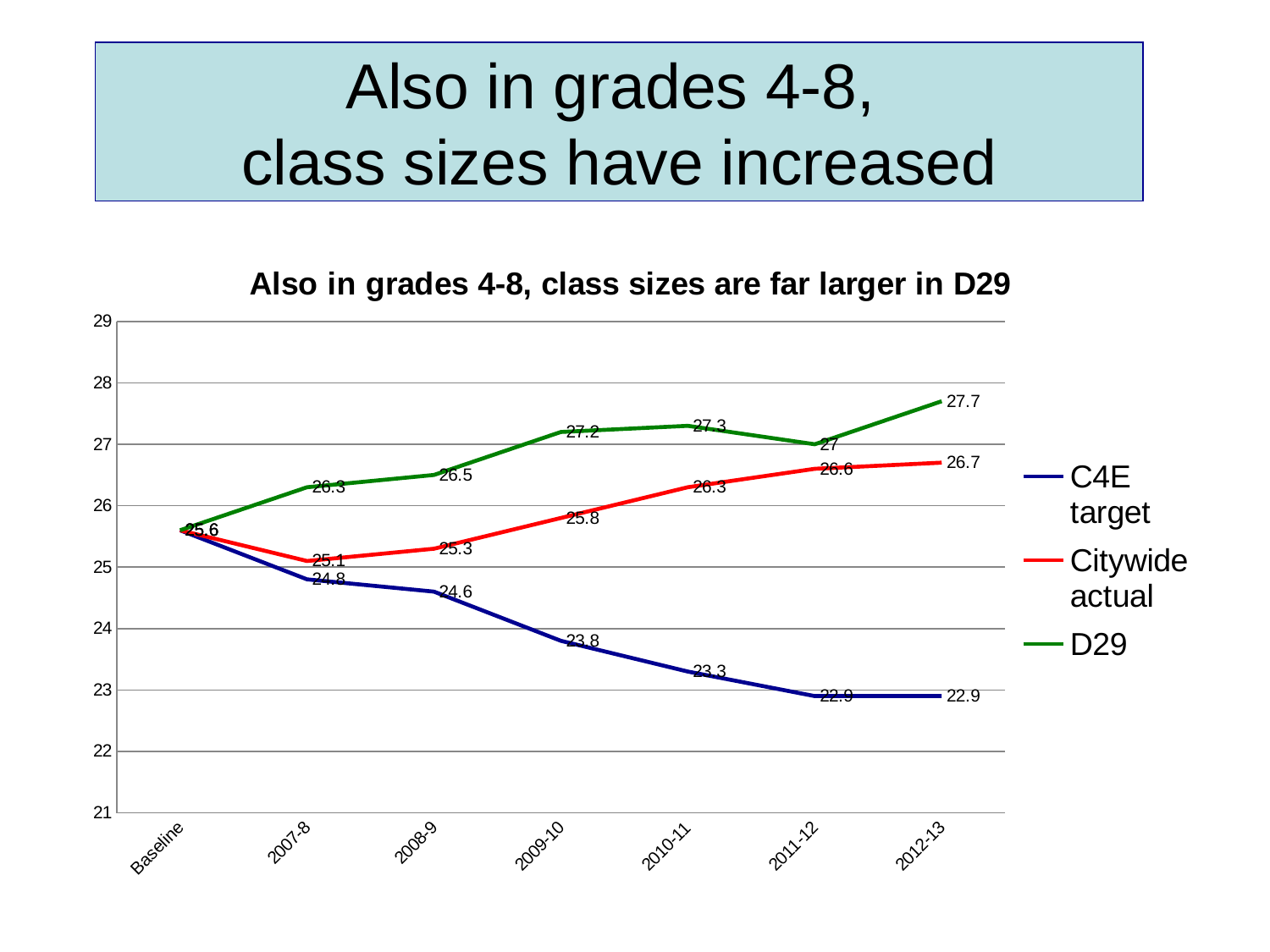
Which is larger in 2009-10, the D29 value or the C4E target value? D29 What is the Citywide actual value for 2012-13? 26.7 What is the difference between the D29 and Citywide actual values in 2012-13? 1 What is the C4E target value for 2012-13? 22.9 What is the D29 value for 2009-10? 27.2 What colour is the D29 line? green Does the C4E target line rise or fall from Baseline to 2012-13? fall What is the D29 value for 2012-13? 27.7 In which year is the D29 value highest? 2012-13 What kind of chart is shown on the slide? line chart How many series does the legend list? 3 How many points along the x axis does each line have? 7